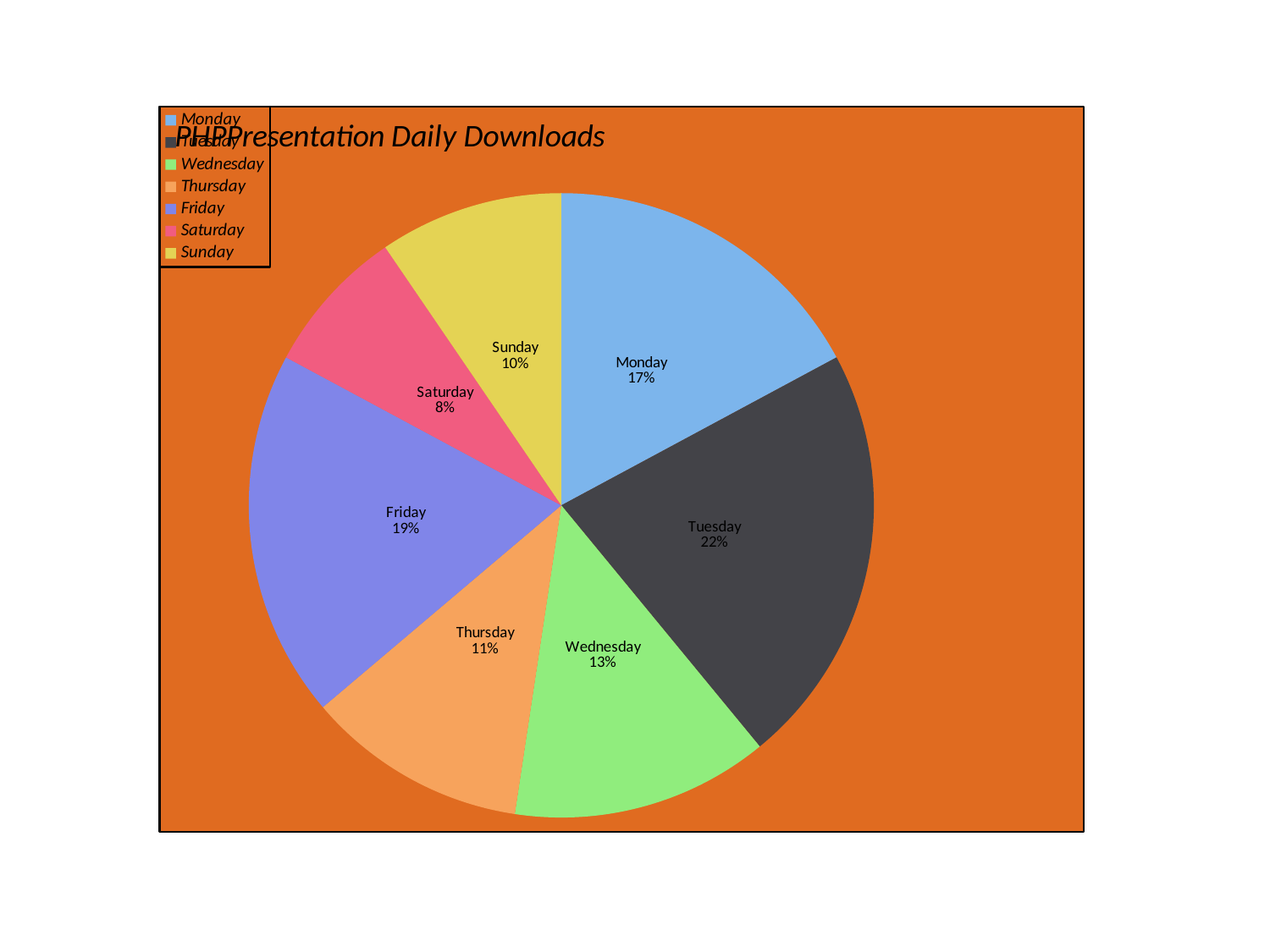
What kind of chart is shown on the slide? pie chart What share of the pie does Friday have? 19% What is the difference in percentage points between Tuesday and Sunday? 12 What percentage is shown for Wednesday? 13% What share of the pie does Tuesday have? 22% What percentage is shown for Saturday? 8% What is the title of the chart? PHPPresentation Daily Downloads Which day has the smallest slice of the pie? Saturday Which is larger, the slice for Monday or the slice for Thursday? Monday What colour is the Friday slice? purple How many slices does the pie chart have? 7 Which day has the largest slice of the pie? Tuesday